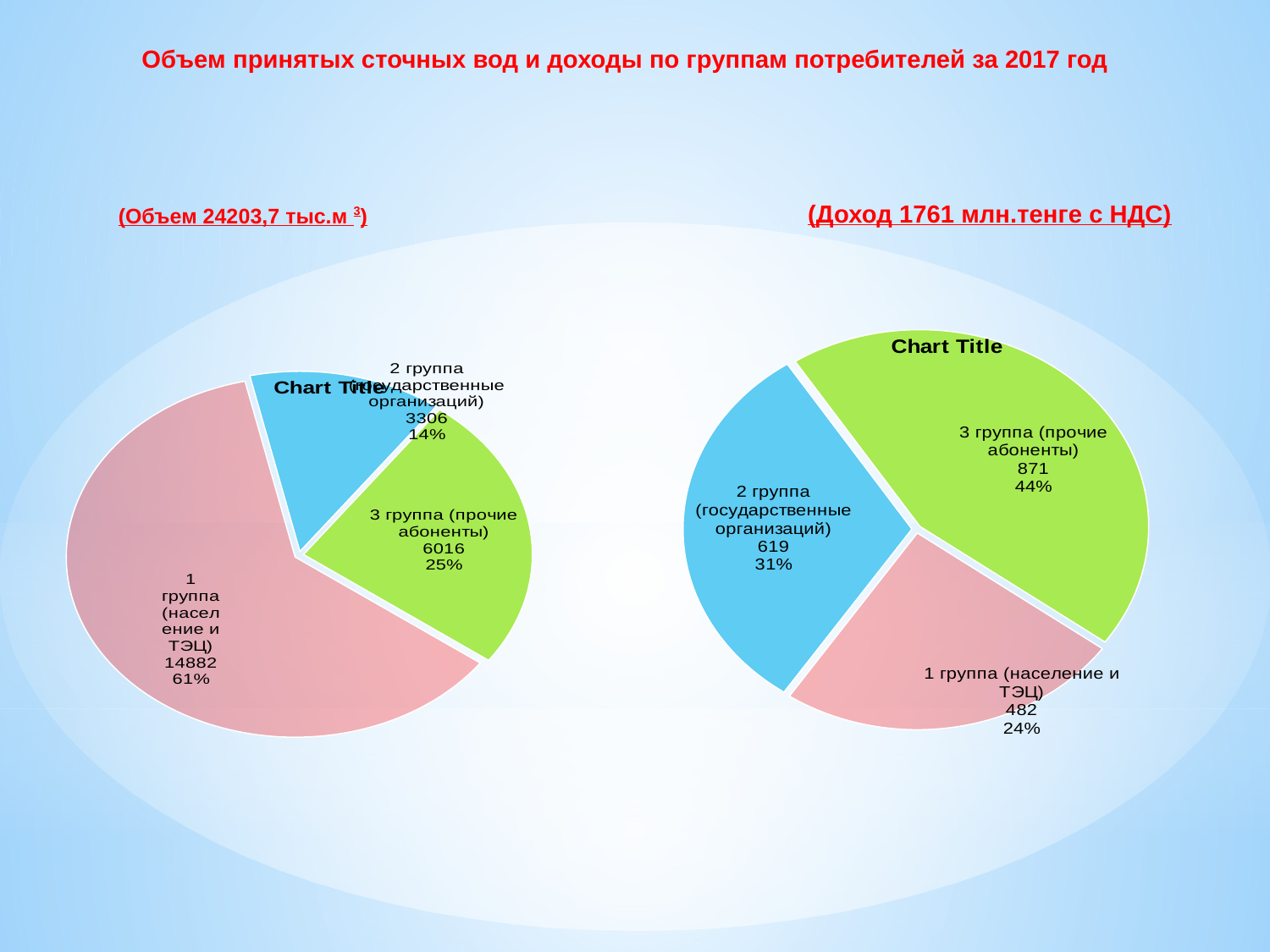
In the left pie chart (Объем), which group has the largest slice? 1 группа (население и ТЭЦ) In the right pie chart (Доход), what is the difference between the values for 3 группа and 1 группа? 389 How many slices does the left pie chart (Объем) have? 3 In the left pie chart (Объем), what percentage share does 3 группа (прочие абоненты) have? 25% What type of chart is used on the right side of the slide (Доход)? Pie chart In the right pie chart (Доход), what percentage share does 2 группа (государственные организаций) have? 31% In the left pie chart (Объем), what value is shown for 2 группа (государственные организаций)? 3306 In the right pie chart (Доход), what value is shown for 3 группа (прочие абоненты)? 871 In the left pie chart (Объем), what value is shown for 1 группа (население и ТЭЦ)? 14882 In the right pie chart (Доход), what value is shown for 1 группа (население и ТЭЦ)? 482 In the right pie chart (Доход), which group has the largest slice? 3 группа (прочие абоненты) In the left pie chart (Объем), which group has the smallest slice? 2 группа (государственные организаций)